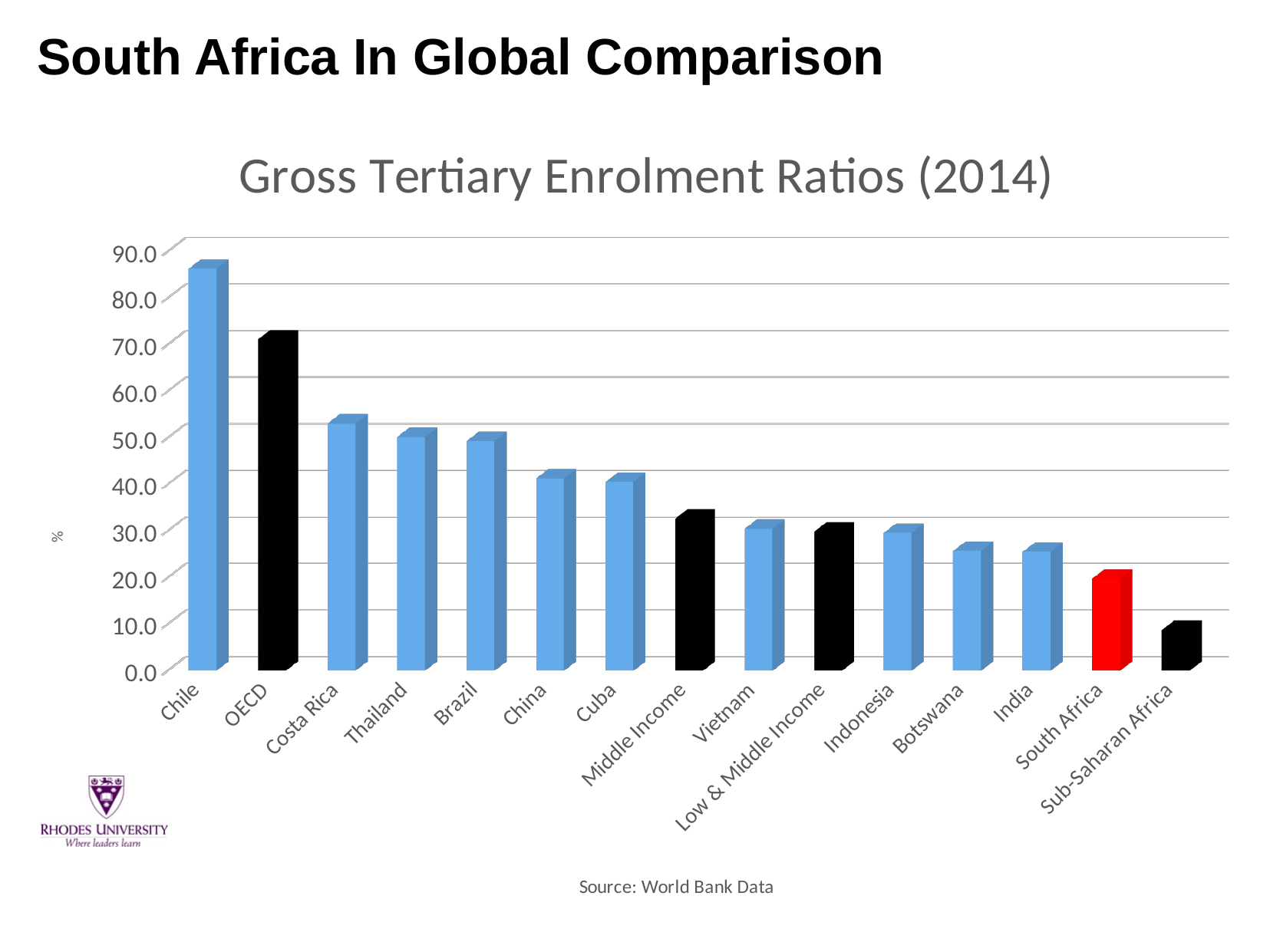
Do the values rise or fall moving from left to right along the x axis? Fall Which category has the lowest gross tertiary enrolment ratio? Sub-Saharan Africa Which has a higher value, Chile or OECD? Chile Is the value for OECD greater or less than 60.0? greater Which category has the highest gross tertiary enrolment ratio? Chile What type of chart is shown on the slide? Bar chart How many categories are plotted on the x axis? 15 Is the value for Chile greater or less than 80.0? greater Is the value for Sub-Saharan Africa greater or less than 20.0? less Which has a higher value, South Africa or Costa Rica? Costa Rica What is the title of the chart? Gross Tertiary Enrolment Ratios (2014)